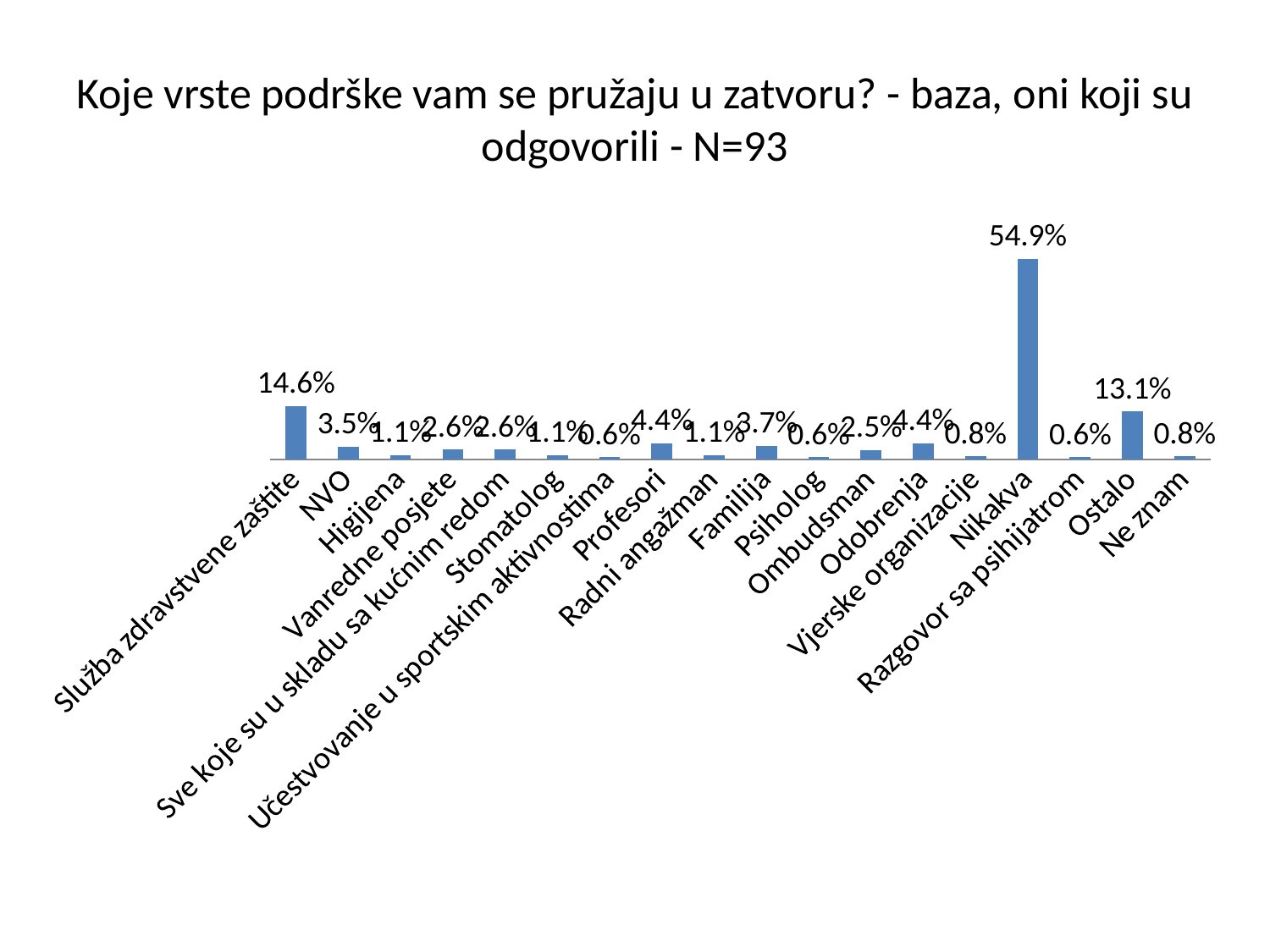
What is the value for Nikakva? 54.9% What is the value for Familija? 3.7% What is the difference between the values for Nikakva and Služba zdravstvene zaštite? 40.3 percentage points How many categories are shown on the x axis? 18 What is the sample size (N) stated in the chart title? N=93 What is the difference between the values for Nikakva and Ostalo? 41.8 percentage points What is the value for Ostalo? 13.1% What type of chart is shown on the slide? Bar chart What is the value for NVO? 3.5% What is the value for Služba zdravstvene zaštite? 14.6% Which is larger, the value for Služba zdravstvene zaštite or the value for Ostalo? Služba zdravstvene zaštite Which category has the highest value? Nikakva